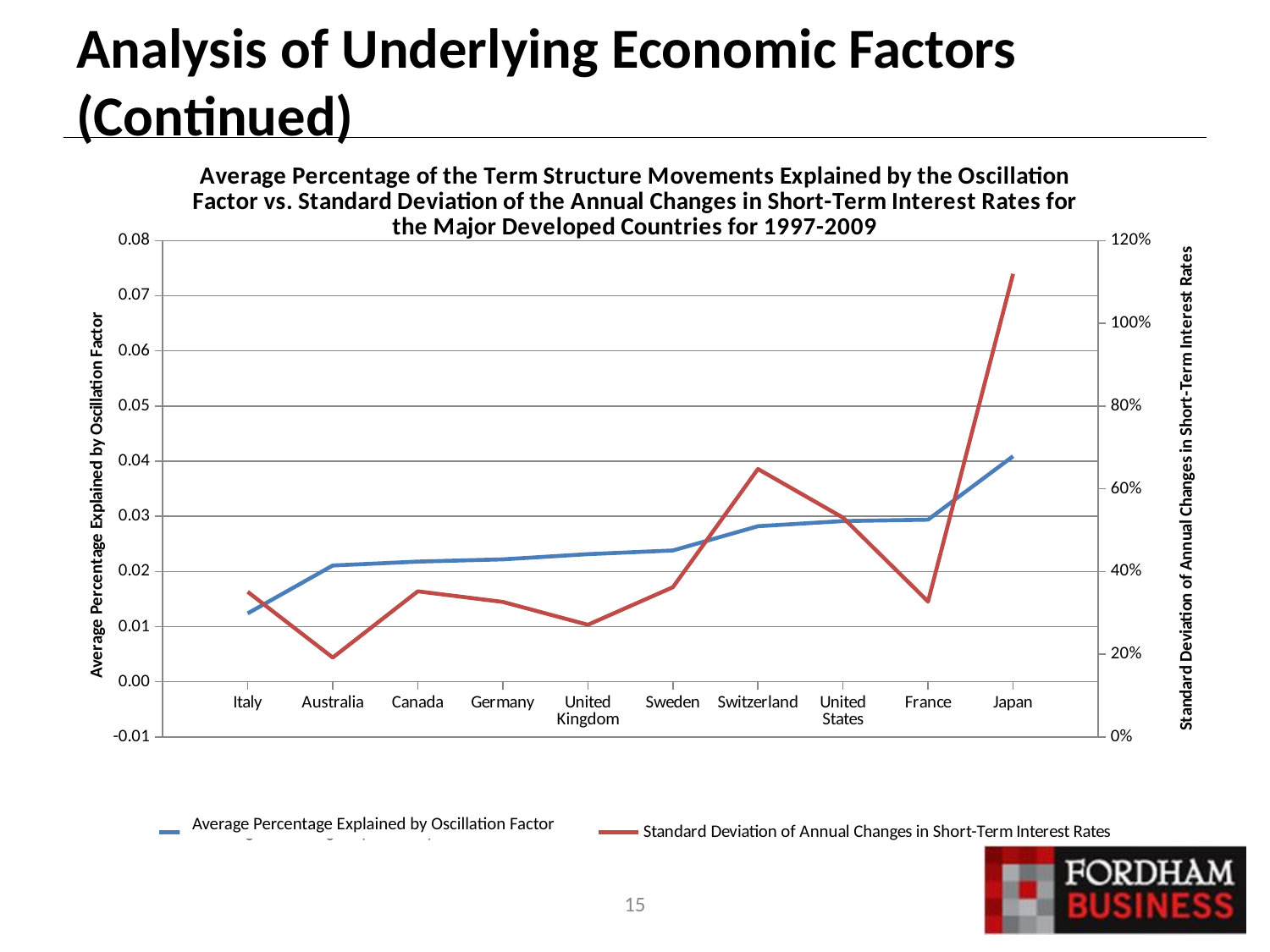
Which country has the highest Standard Deviation of Annual Changes in Short-Term Interest Rates? Japan Does the Average Percentage Explained by Oscillation Factor line generally rise or fall from Italy to Japan? Rise Which country has the lowest Standard Deviation of Annual Changes in Short-Term Interest Rates? Australia How many countries are plotted along the x axis? 10 Which country has the highest value for Average Percentage Explained by Oscillation Factor? Japan What colour is the line for Standard Deviation of Annual Changes in Short-Term Interest Rates? Red Is the Average Percentage Explained by Oscillation Factor for Italy greater or less than 0.02? less Is the Standard Deviation of Annual Changes in Short-Term Interest Rates for Japan greater or less than 100%? greater How many series does the legend list? 2 What kind of chart is shown on the slide? Line chart Which country has the lowest value for Average Percentage Explained by Oscillation Factor? Italy Which has a larger Standard Deviation of Annual Changes in Short-Term Interest Rates, Switzerland or the United States? Switzerland